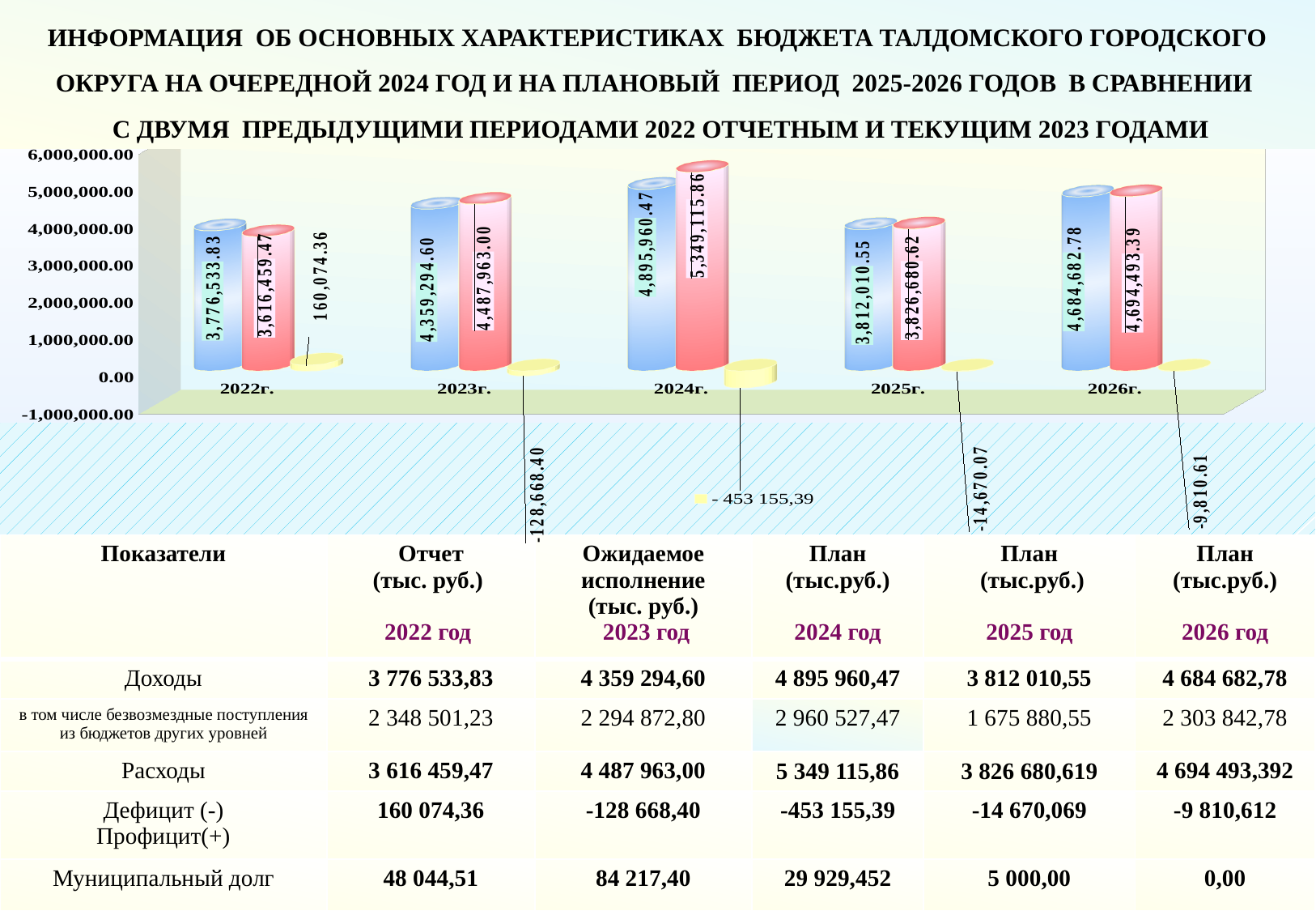
What is the value of the red bar (Расходы) for 2024г. on the chart? 5,349,115.86 What is the value of the yellow marker (Дефицит/Профицит) for 2023г. on the chart? -128,668.40 In which year is the blue bar (Доходы) the highest? 2024г. In which year is the red bar (Расходы) the highest? 2024г. What is the value of the blue bar (Доходы) for 2022г. on the chart? 3,776,533.83 What is the difference between the red bar and the blue bar for 2024г.? 453,155.39 What kind of chart is shown on the slide? bar chart In which year is the blue bar (Доходы) the lowest? 2022г. For 2023г., which is larger: the blue bar or the red bar? the red bar Is the value of the blue bar for 2022г. greater or less than 3,000,000.00? greater What is the value of the blue bar for 2026г. on the chart? 4,684,682.78 How many years (categories) are shown on the x axis of the chart? 5